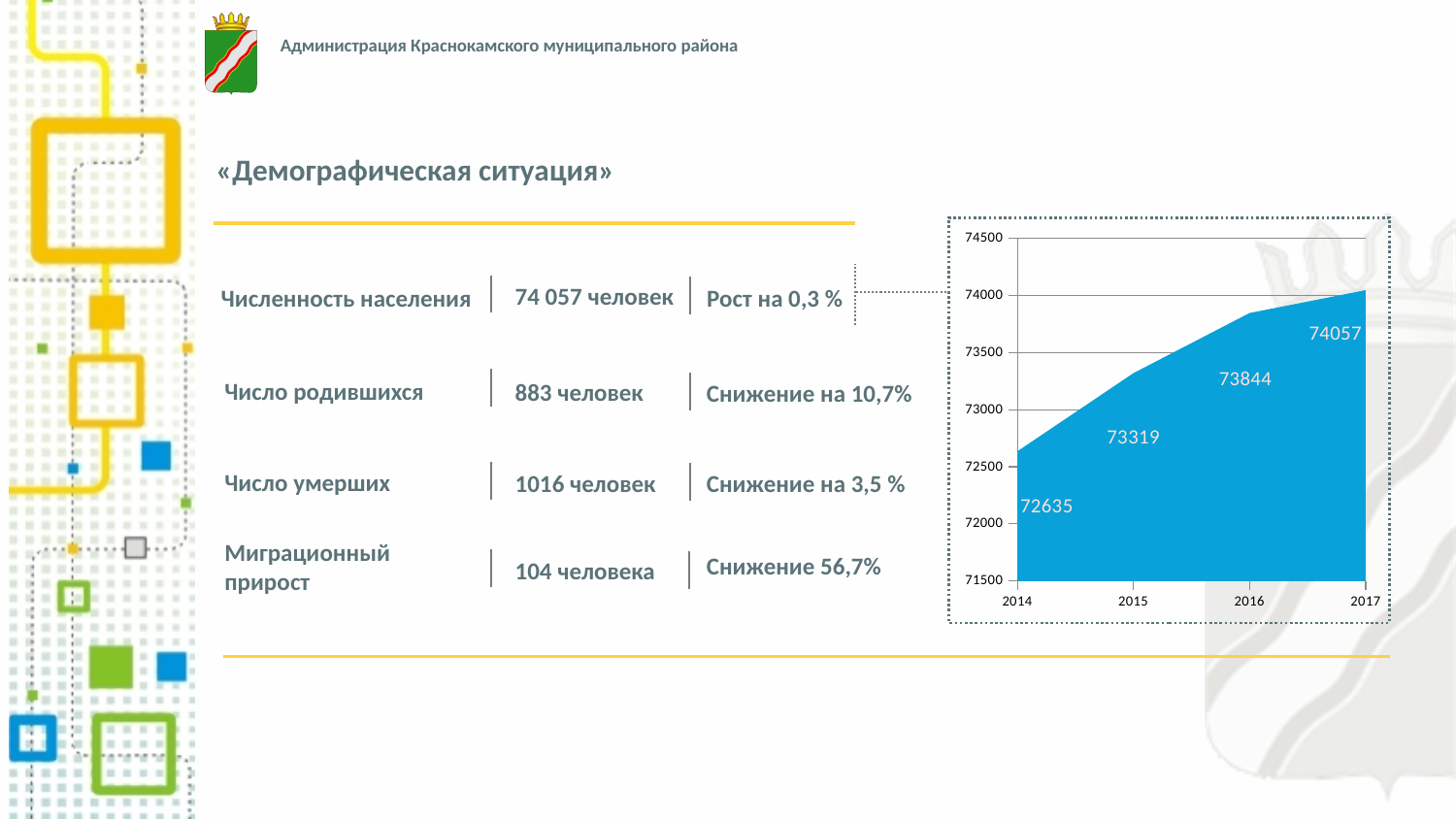
What is the value shown for 2015 on the chart? 73319 Which year has the highest value on the chart? 2017 Which year has the lowest value on the chart? 2014 What is the difference between the 2017 value and the 2014 value? 1422 What is the value shown for 2017 on the chart? 74057 Which is larger, the value for 2015 or the value for 2016? 2016 Do the values rise or fall from 2014 to 2017? rise Is the value for 2014 greater or less than 73000? less How many years are plotted on the chart? 4 What is the difference between the 2016 value and the 2015 value? 525 What is the value shown for 2016 on the chart? 73844 What is the value shown for 2014 on the chart? 72635